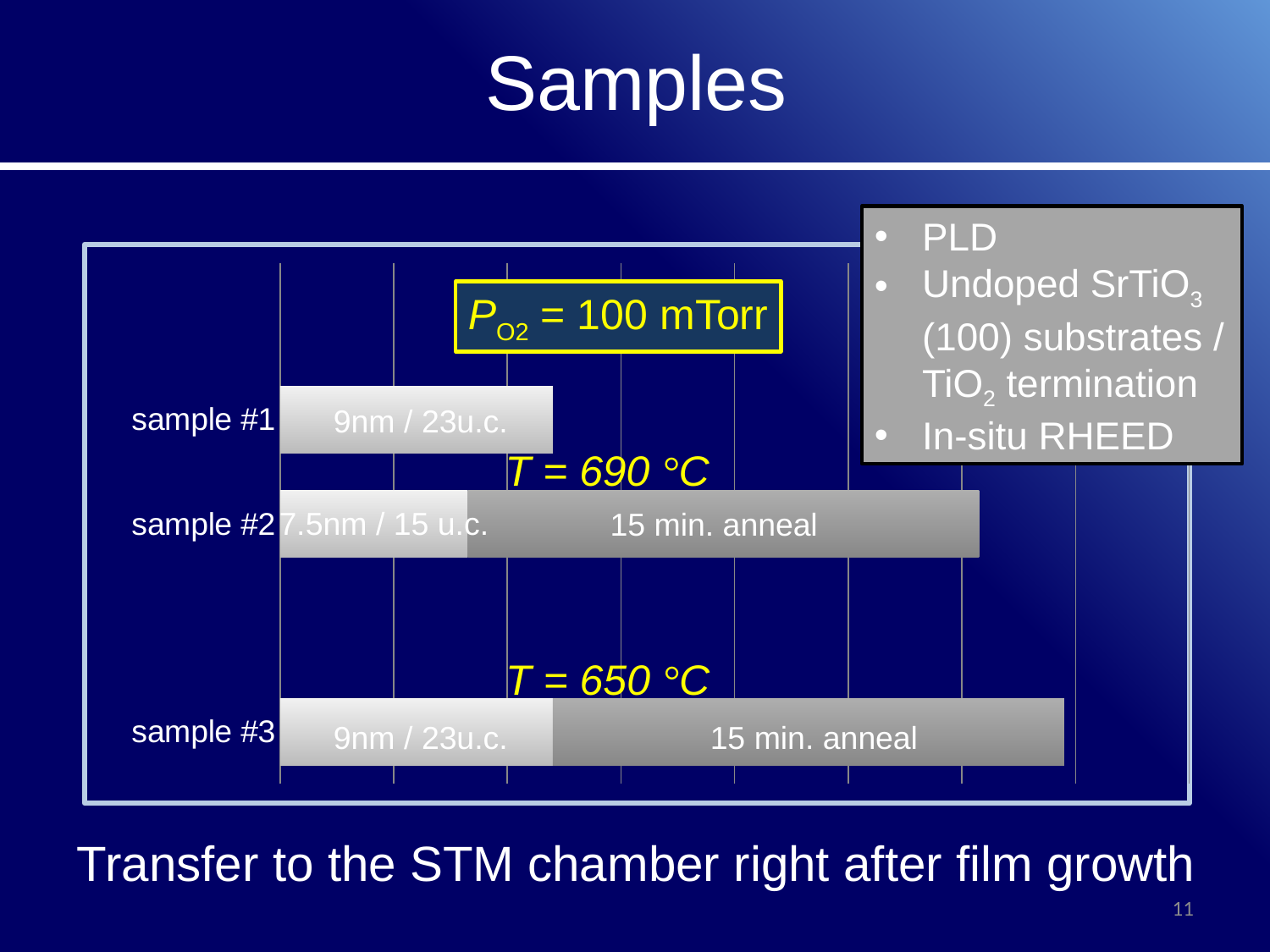
Which sample has the shortest bar in the chart? sample #1 How many samples are listed as categories in the chart? 3 What label is printed on the bar for sample #1? 9nm / 23u.c. Which sample's bar is longer, sample #2 or sample #3? sample #3 What film thickness label is printed on the first segment of the bar for sample #2? 7.5nm / 15 u.c. What kind of chart is shown on the slide? bar chart Which sample's bar does not include a '15 min. anneal' segment? sample #1 Which sample has the longest bar in the chart? sample #3 What temperature is annotated above the bar for sample #3? T = 650 °C What oxygen pressure is shown in the boxed annotation on the chart? P_O2 = 100 mTorr What label is printed on the second segment of the bar for sample #3? 15 min. anneal What temperature is annotated above the bar for sample #2? T = 690 °C